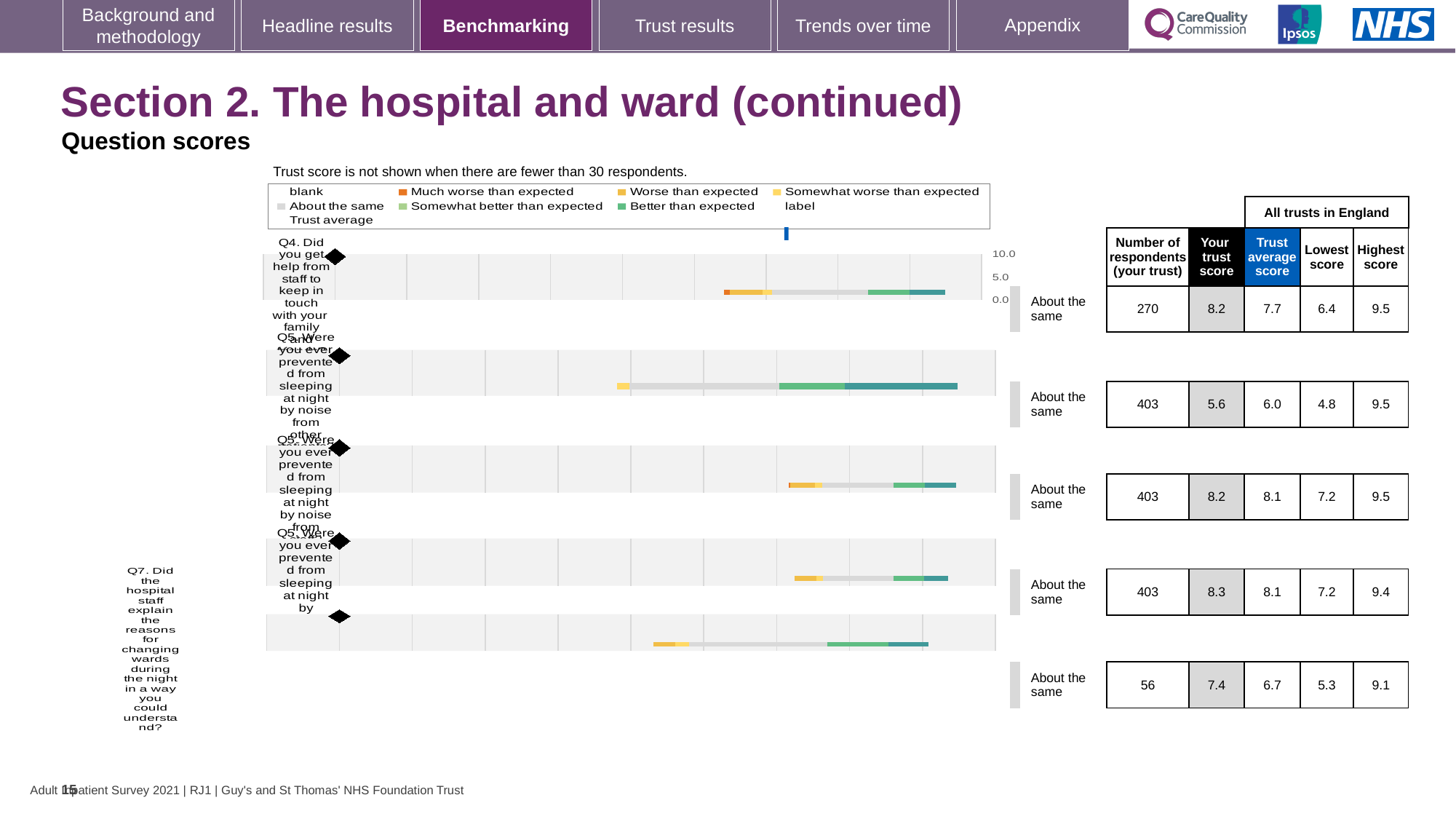
What is the trust average score for Q7? 6.7 By how much does the 'Your trust score' for Q4 exceed the trust average score for Q4? 0.5 What kind of chart is used to show the question scores on this slide? bar chart What is the highest 'Your trust score' value shown in the table on this slide? 8.3 How many question rows are plotted in the question scores chart? 5 What is the 'Your trust score' for Q4 (help from staff to keep in touch with family and friends)? 8.2 What is the lowest 'Your trust score' value shown in the table on this slide? 5.6 For Q7, which is larger: the 'Your trust score' or the trust average score? Your trust score What is the trust average score for Q4? 7.7 How many respondents (your trust) are shown for Q7? 56 How many respondents (your trust) are shown for Q4? 270 What is the 'Your trust score' for Q7 (explaining reasons for changing wards during the night)? 7.4